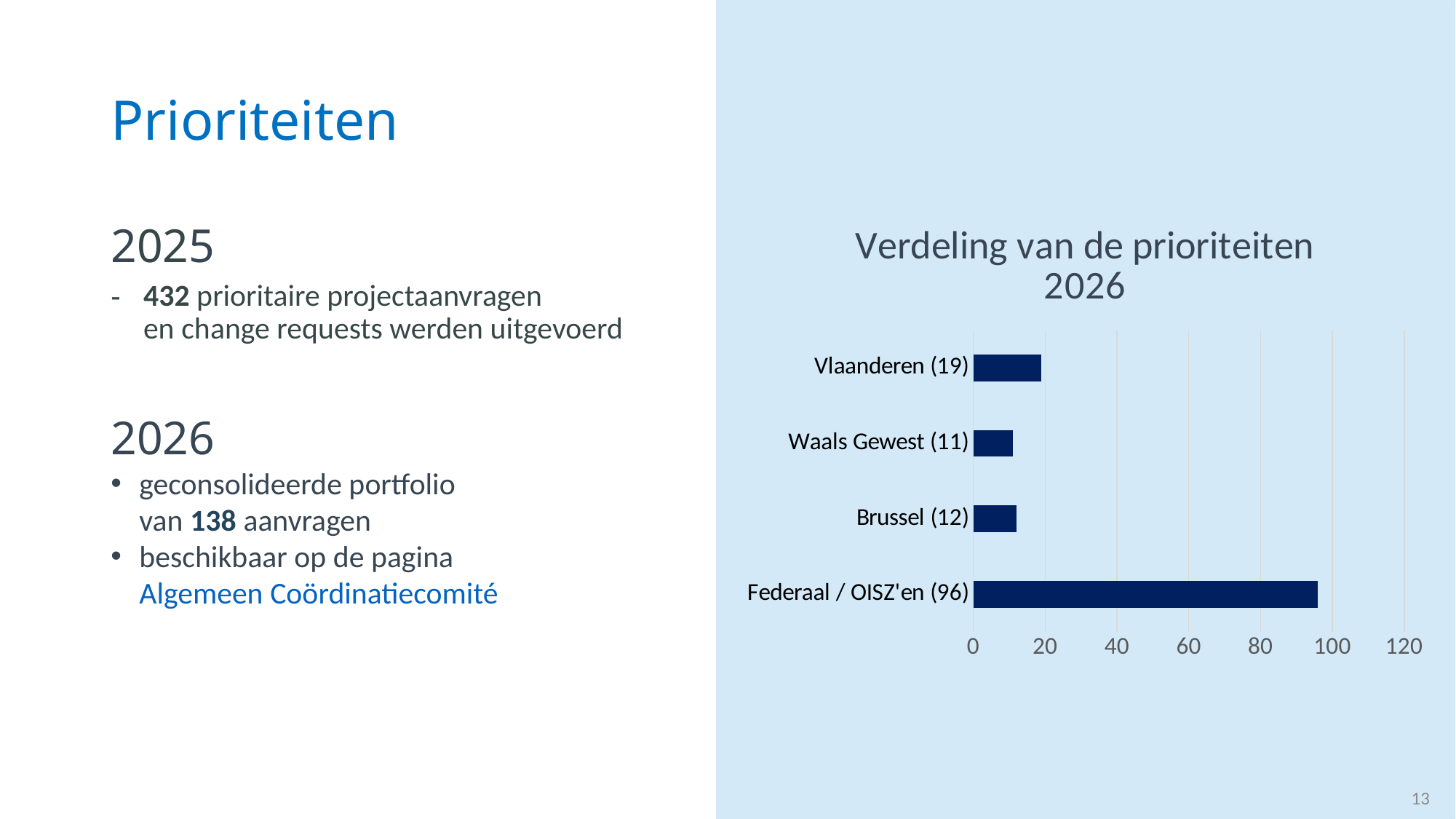
What is the title of the chart? Verdeling van de prioriteiten 2026 What is the difference between the values for Federaal / OISZ'en and Vlaanderen? 77 What is the value for Vlaanderen in the chart? 19 What is the value for Federaal / OISZ'en in the chart? 96 Is the value for Federaal / OISZ'en greater or less than 80? greater Which is larger, the value for Vlaanderen or the value for Brussel? Vlaanderen What is the difference between the values for Brussel and Waals Gewest? 1 What is the value for Waals Gewest in the chart? 11 What kind of chart is shown on the slide? Bar chart Which category has the lowest value in the chart? Waals Gewest How many categories are shown in the chart? 4 Which category has the highest value in the chart? Federaal / OISZ'en